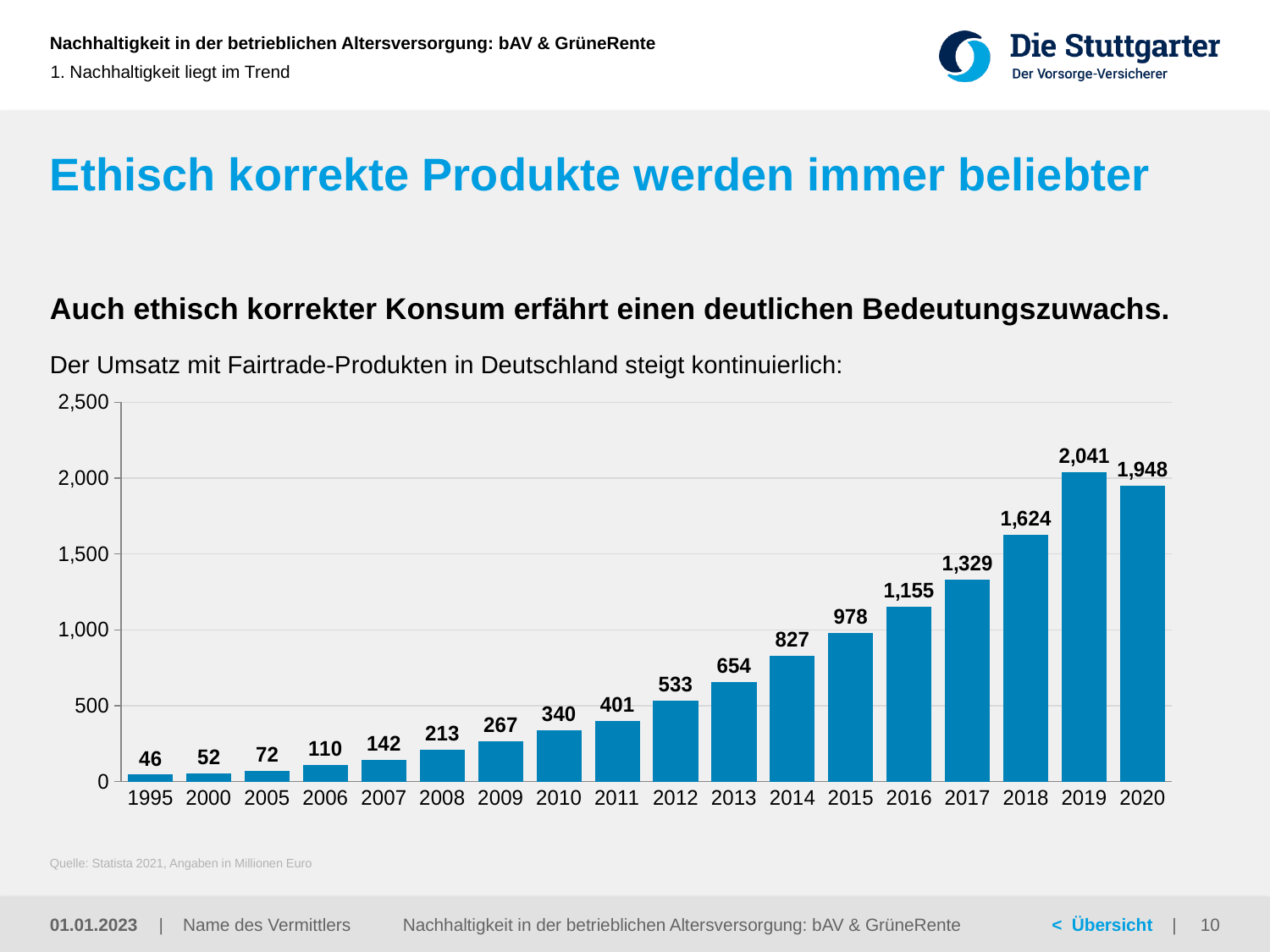
What is the value for 2008? 213 What is the value for 2019? 2,041 Which year has the lowest value? 1995 What is the difference between the values for 2016 and 2017? 174 How many years are shown on the x axis? 18 What is the value for 1995? 46 What is the difference between the values for 2019 and 2020? 93 Is the value for 2018 greater or less than 1,500? greater Which year has the highest value? 2019 What kind of chart is shown? bar chart Which is larger, the value for 2014 or the value for 2015? 2015 Do the values generally rise or fall from 1995 to 2019? rise